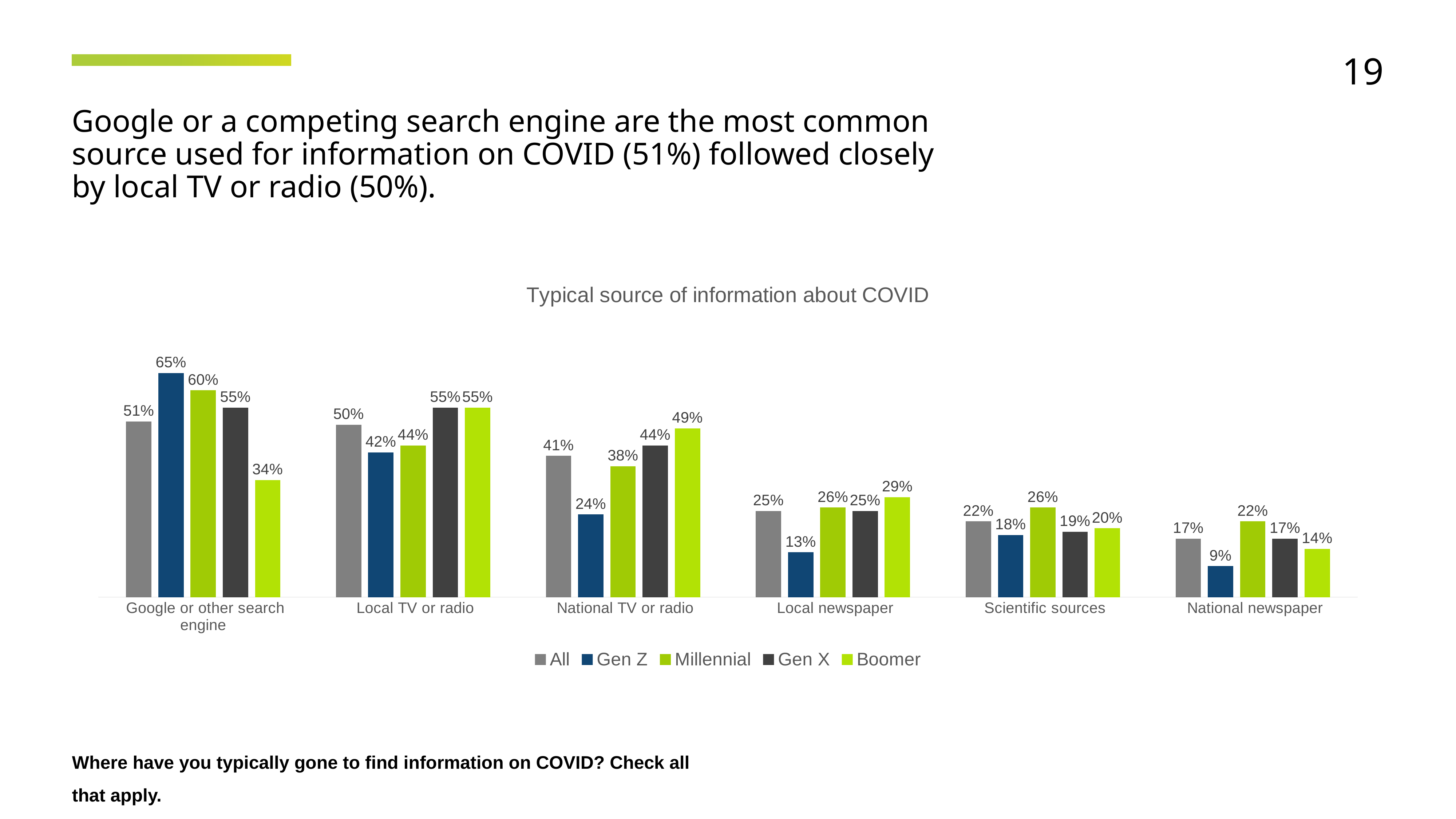
How many series does the legend list? 5 Which category has the lowest value for the Gen Z series? National newspaper What is the value for Gen Z for Google or other search engine? 65% What is the difference between the Gen Z and Boomer values for Google or other search engine? 31% What is the title of the chart? Typical source of information about COVID Which is larger for Local newspaper: the Gen Z value or the Boomer value? Boomer What is the value for Gen Z for National newspaper? 9% What is the value for Boomer for National TV or radio? 49% What is the value for All for Local TV or radio? 50% How many categories are shown on the x axis? 6 Which category has the highest value for the All series? Google or other search engine What kind of chart is shown on the slide? Bar chart